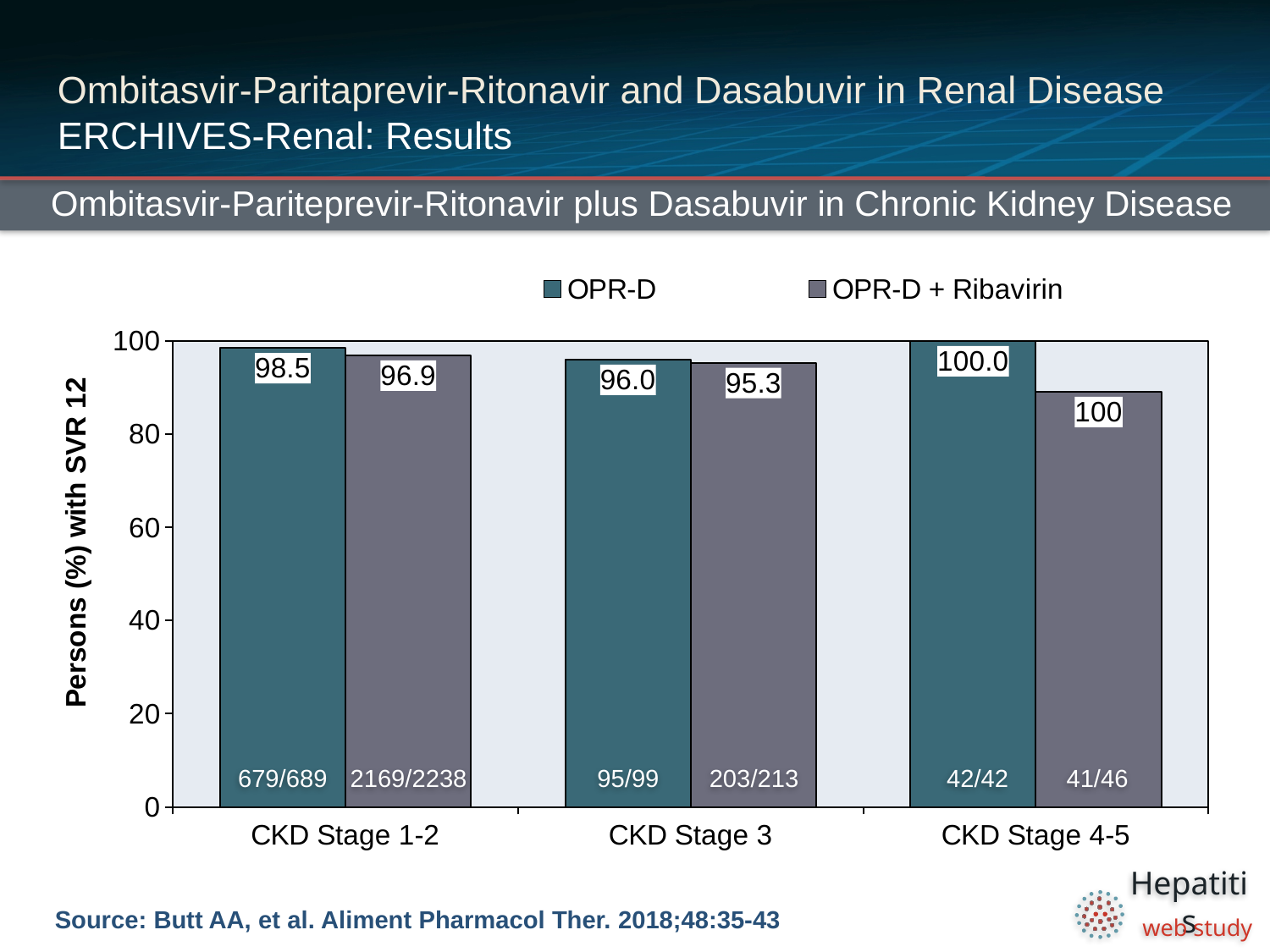
What is the SVR 12 percentage for OPR-D + Ribavirin in CKD Stage 3? 95.3 How many CKD stage categories are shown on the x axis? 3 Which CKD stage has the highest value for the OPR-D series? CKD Stage 4-5 What is the SVR 12 percentage for OPR-D + Ribavirin in CKD Stage 1-2? 96.9 What kind of chart is shown on the slide? bar chart Which CKD stage has the lowest value for the OPR-D series? CKD Stage 3 How many series does the legend list? 2 What is the difference between the OPR-D and OPR-D + Ribavirin values in CKD Stage 1-2? 1.6 What is the SVR 12 percentage for OPR-D in CKD Stage 4-5? 100.0 What is the y-axis label of the chart? Persons (%) with SVR 12 What is the SVR 12 percentage for OPR-D in CKD Stage 1-2? 98.5 What is the SVR 12 percentage for OPR-D in CKD Stage 3? 96.0